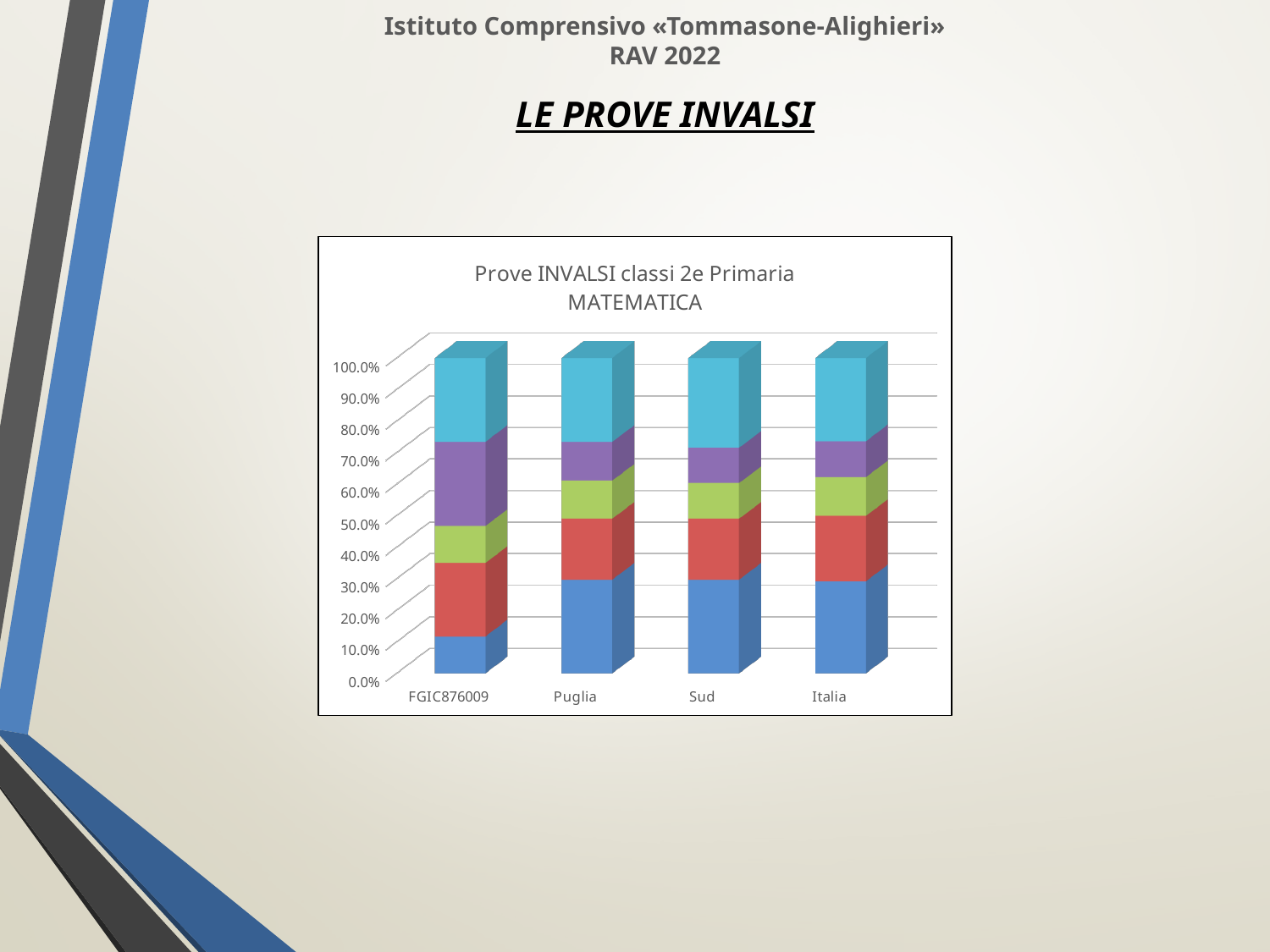
What is the total height of the stacked bar for Italia? 100.0% Which category has the largest purple segment? FGIC876009 Is the purple segment larger for FGIC876009 or for Sud? FGIC876009 What kind of chart is shown on the slide? Stacked bar chart Is the top of the red segment for FGIC876009 greater or less than 30.0%? greater Which category is shown first on the x axis of the chart? FGIC876009 How many categories are shown on the x axis of the chart? 4 Is the top of the bottom (blue) segment for FGIC876009 greater or less than 20.0%? less Which category has the smallest bottom (blue) segment? FGIC876009 How many coloured segments make up each stacked bar? 5 What is the title of the chart? Prove INVALSI classi 2e Primaria MATEMATICA Is the bottom (blue) segment larger for FGIC876009 or for Puglia? Puglia